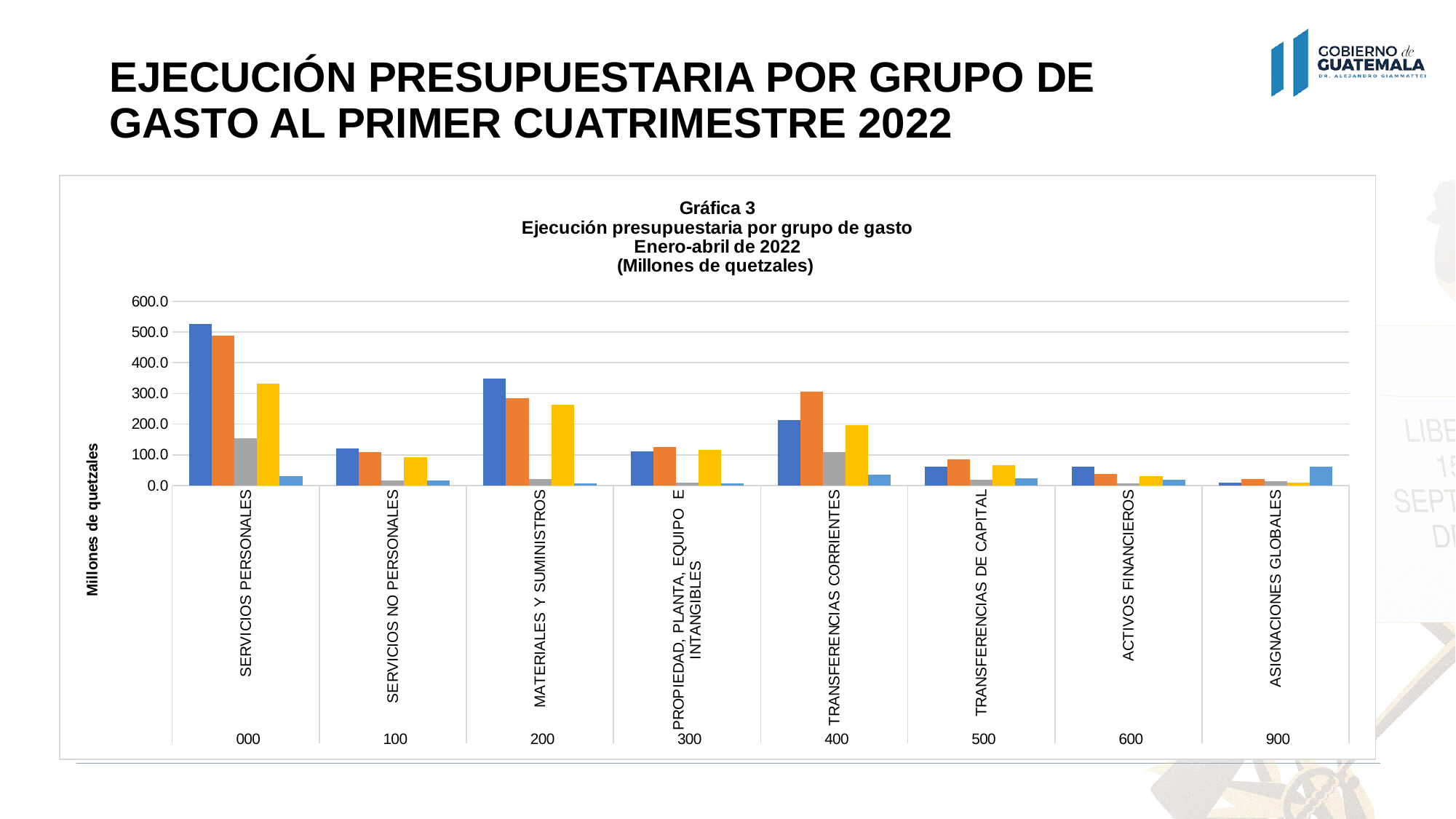
Is the value of the orange bar for SERVICIOS PERSONALES greater or less than 500.0? less How many expense group categories are shown along the x axis? 8 Is the value of the yellow bar for MATERIALES Y SUMINISTROS greater or less than 300.0? less Is the value of the orange bar for TRANSFERENCIAS DE CAPITAL greater or less than 100.0? less For SERVICIOS PERSONALES, which is larger: the dark blue bar or the orange bar? the dark blue bar Which category has the tallest bar in the chart? SERVICIOS PERSONALES What kind of chart is shown on the slide? bar chart For TRANSFERENCIAS CORRIENTES, which is larger: the dark blue bar or the orange bar? the orange bar What is the label of the vertical axis of the chart? Millones de quetzales